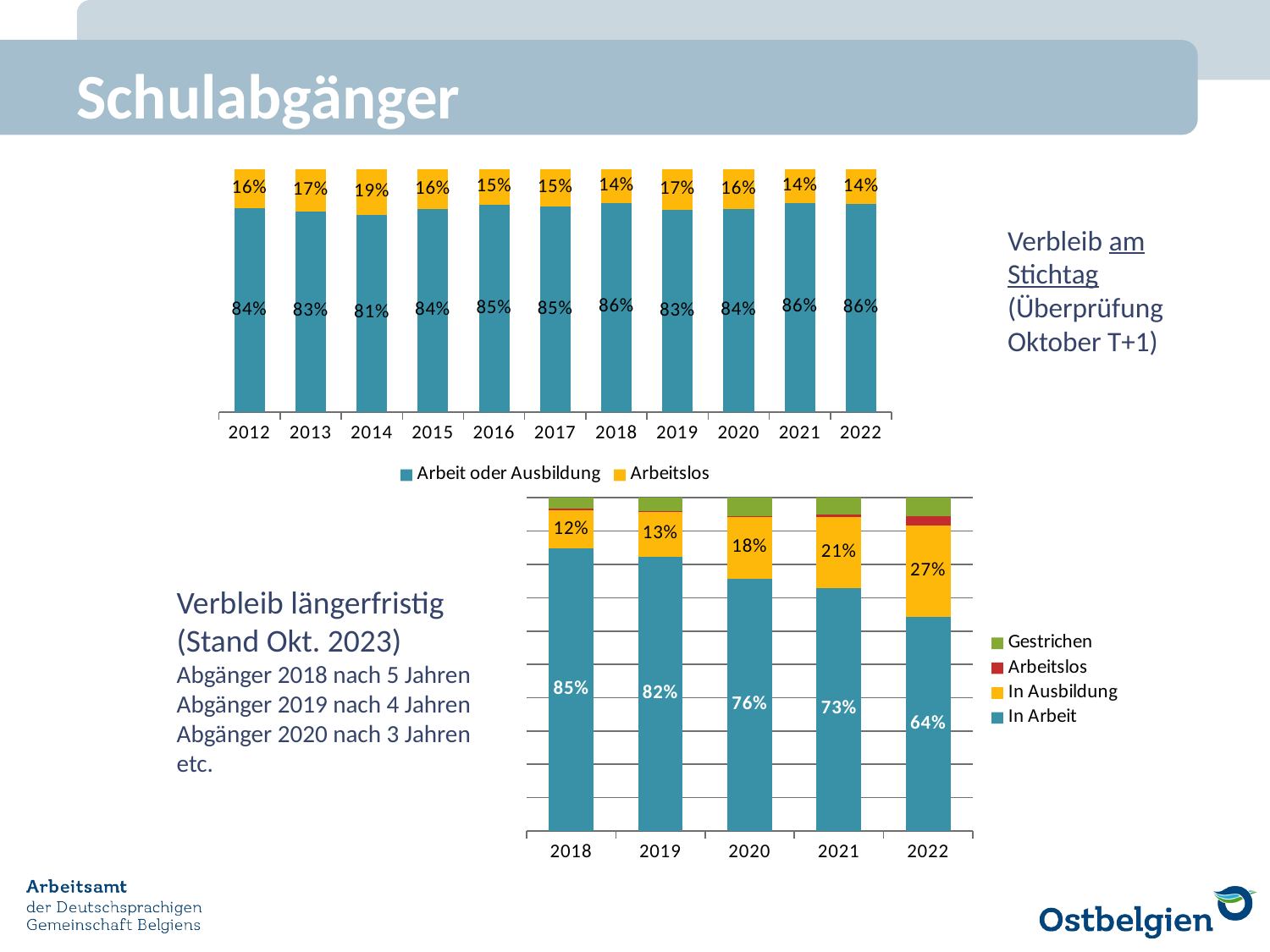
In the top chart, which year has the lowest Arbeit oder Ausbildung share? 2014 In the top chart, what is the value for Arbeitslos in 2019? 17% In the top chart, how many years are shown on the x axis? 11 In the bottom chart, what is the value for In Ausbildung in 2022? 27% In the top chart, what is the value for Arbeit oder Ausbildung in 2014? 81% In the top chart, how many series does the legend list? 2 In the bottom chart, does the In Arbeit share rise or fall from 2018 to 2022? fall In the bottom chart, what is the value for In Arbeit in 2021? 73% In the top chart, which year has the highest Arbeitslos share? 2014 In the bottom chart, how many series does the legend list? 4 What kind of chart is the bottom chart? stacked bar chart In the bottom chart, what is the difference between the In Arbeit values for 2018 and 2022? 21%